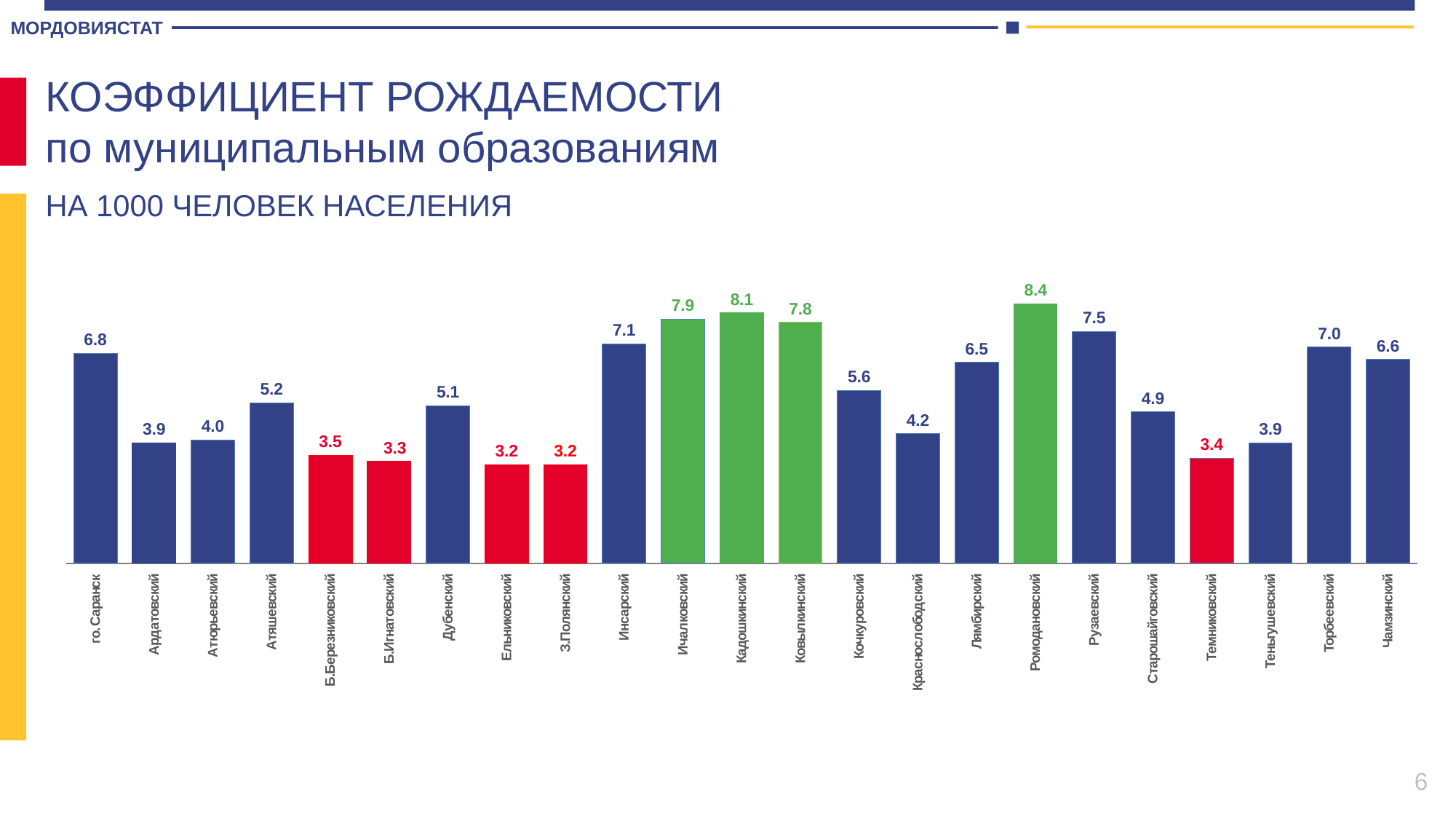
Which municipality has the highest birth rate on the chart? Ромодановский What is the birth rate value for го.Саранск? 6.8 Which has a higher value, Рузаевский or Лямбирский? Рузаевский Which has a higher value, Атяшевский or Дубенский? Атяшевский What type of chart is shown on the slide? Bar chart What is the value shown for Старошайговский? 4.9 What is the difference between the values for Ромодановский and Темниковский? 5.0 What colour are the bars for the municipalities with the highest values, such as Ромодановский and Кадошкинский? Green How many municipalities are shown on the chart? 23 What is the lowest value shown on the chart? 3.2 What is the value shown for Кадошкинский? 8.1 What is the difference between the values for Инсарский and Краснослободский? 2.9